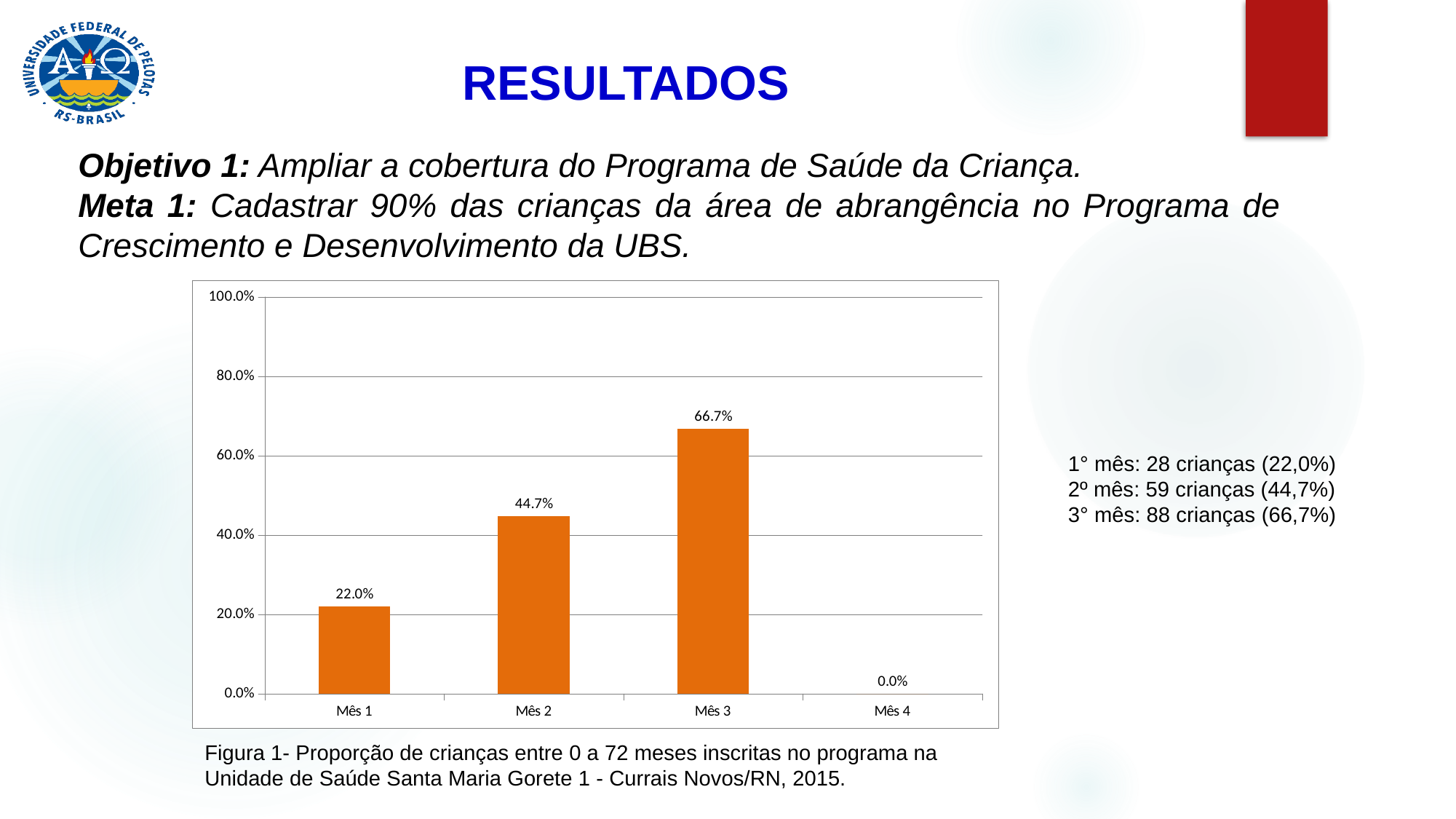
How many categories are shown on the x axis? 4 Is the value for Mês 2 greater or less than 40.0%? greater What is the value for Mês 3? 66.7% Do the values rise or fall from Mês 1 to Mês 3? Rise What is the value for Mês 4? 0.0% Which is larger, the value for Mês 2 or the value for Mês 3? Mês 3 What is the value for Mês 2? 44.7% What kind of chart is shown on the slide? Bar chart What is the difference between the values for Mês 3 and Mês 1? 44.7% Which month has the highest value? Mês 3 What is the value for Mês 1? 22.0% Which month has the lowest value? Mês 4